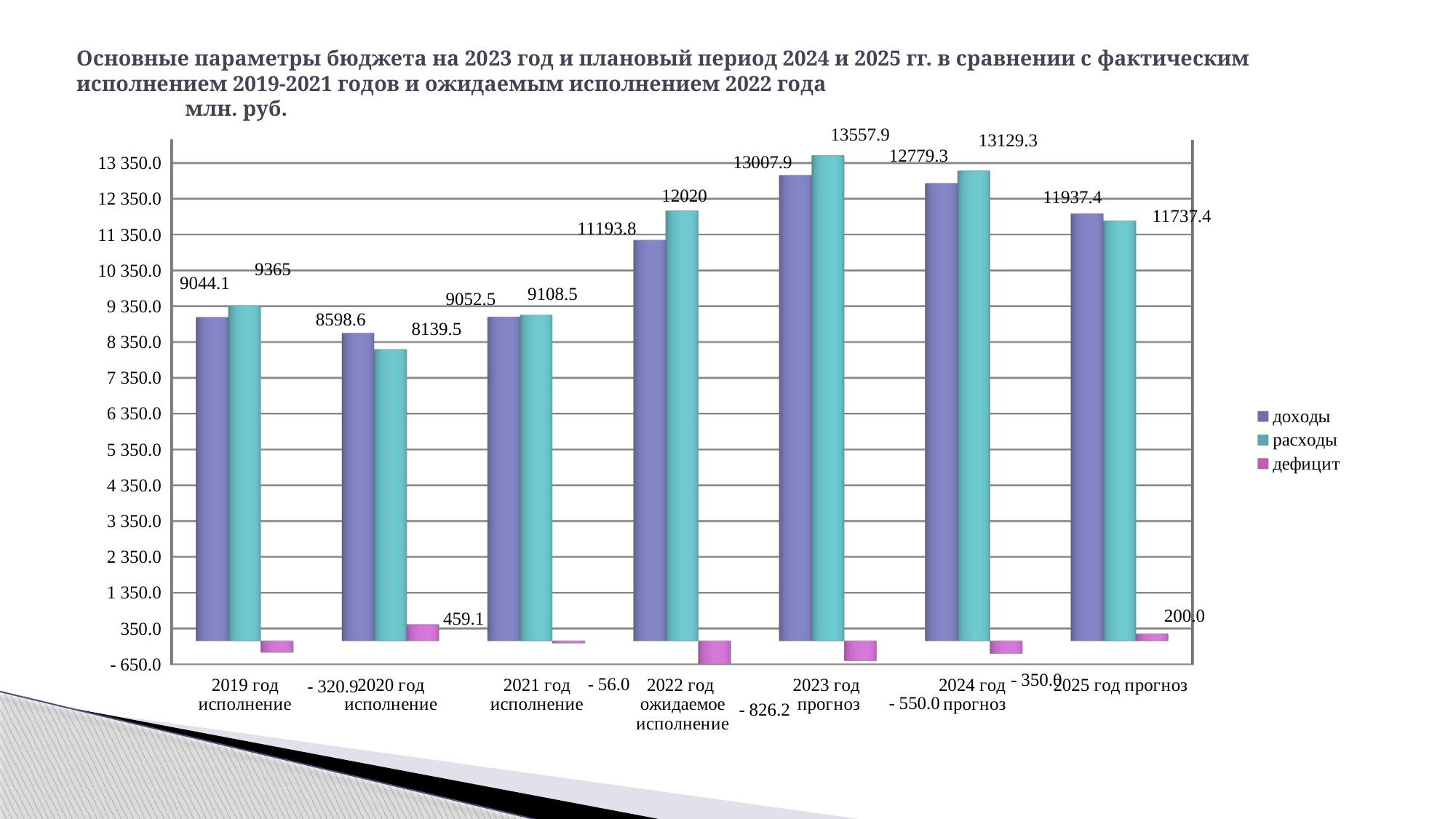
Do the values of доходы rise or fall from 2023 год прогноз to 2025 год прогноз? fall How many series does the legend list? 3 In 2025 год прогноз, which is larger: доходы or расходы? доходы What is the value of дефицит for 2020 год исполнение? 459.1 What is the value of расходы for 2022 год ожидаемое исполнение? 12020 By how much do расходы exceed доходы in 2023 год прогноз? 550.0 What unit of measurement is stated above the chart? млн. руб. How many year categories are shown on the x axis? 7 What type of chart is shown on the slide? bar chart What is the value of доходы for 2023 год прогноз? 13007.9 Which year has the lowest value of доходы? 2020 год исполнение Which year has the highest value of расходы? 2023 год прогноз